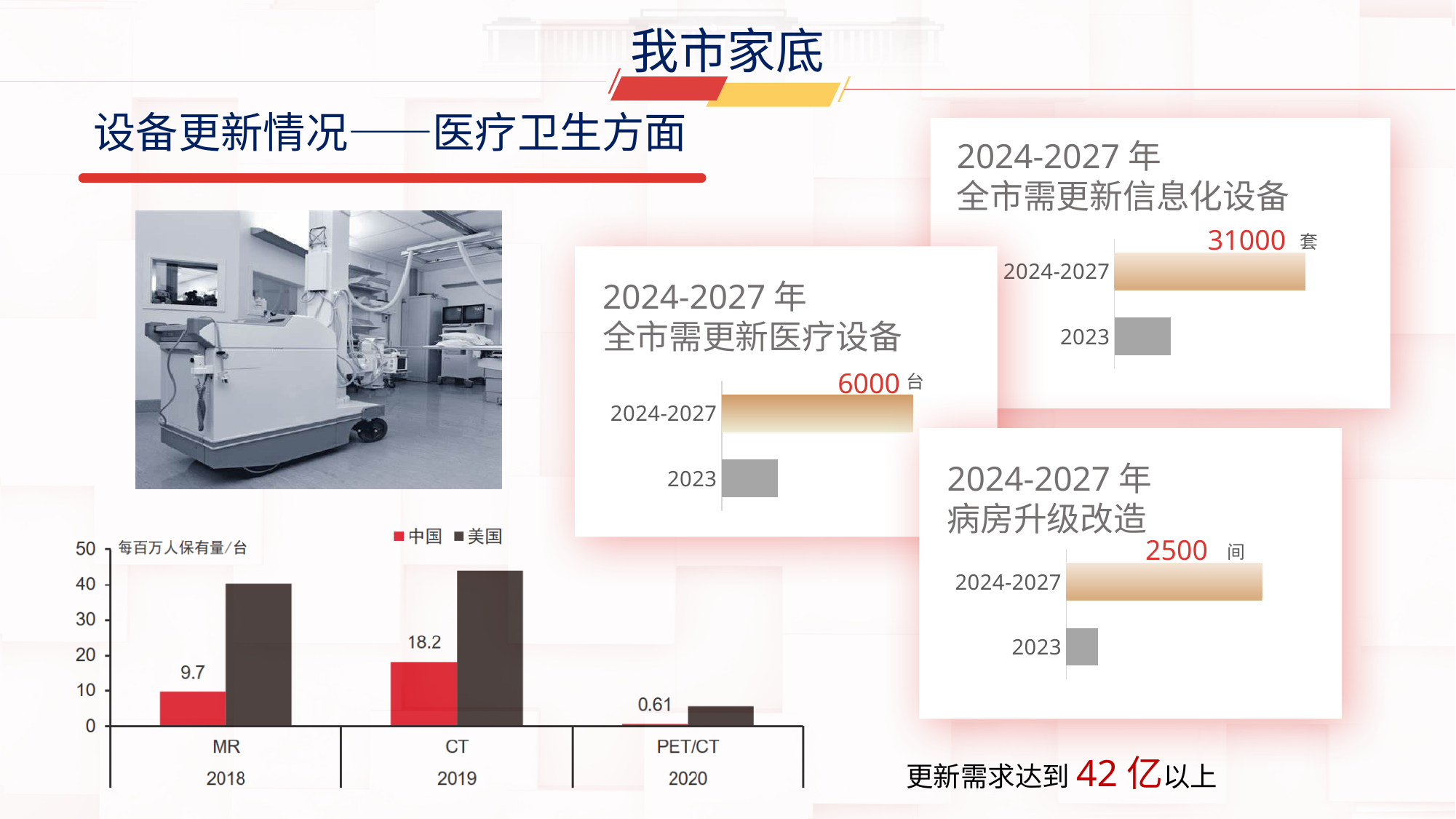
In the chart titled 2024-2027 年 全市需更新医疗设备, what is the value for 2024-2027? 6000 台 In the chart titled 2024-2027 年 病房升级改造, what is the value for 2024-2027? 2500 间 In the bottom-left chart (每百万人保有量/台), what is the difference between the 中国 values for CT and MR? 8.5 In the bottom-left chart (每百万人保有量/台), how many series does the legend list? 2 In the bottom-left chart (每百万人保有量/台), how many categories are shown on the x axis? 3 In the bottom-left chart (每百万人保有量/台), which category has the highest value for 中国? CT In the bottom-left chart (每百万人保有量/台), what is the value for 中国 for MR? 9.7 In the bottom-left chart (每百万人保有量/台), for MR, which series is larger, 中国 or 美国? 美国 In the bottom-left chart (每百万人保有量/台), what is the value for 中国 for CT? 18.2 In the bottom-left chart (每百万人保有量/台), what is the value for 中国 for PET/CT? 0.61 In the chart titled 2024-2027 年 全市需更新信息化设备, what is the value for 2024-2027? 31000 套 In the bottom-left chart (每百万人保有量/台), is the value for 美国 for MR greater or less than 30? greater